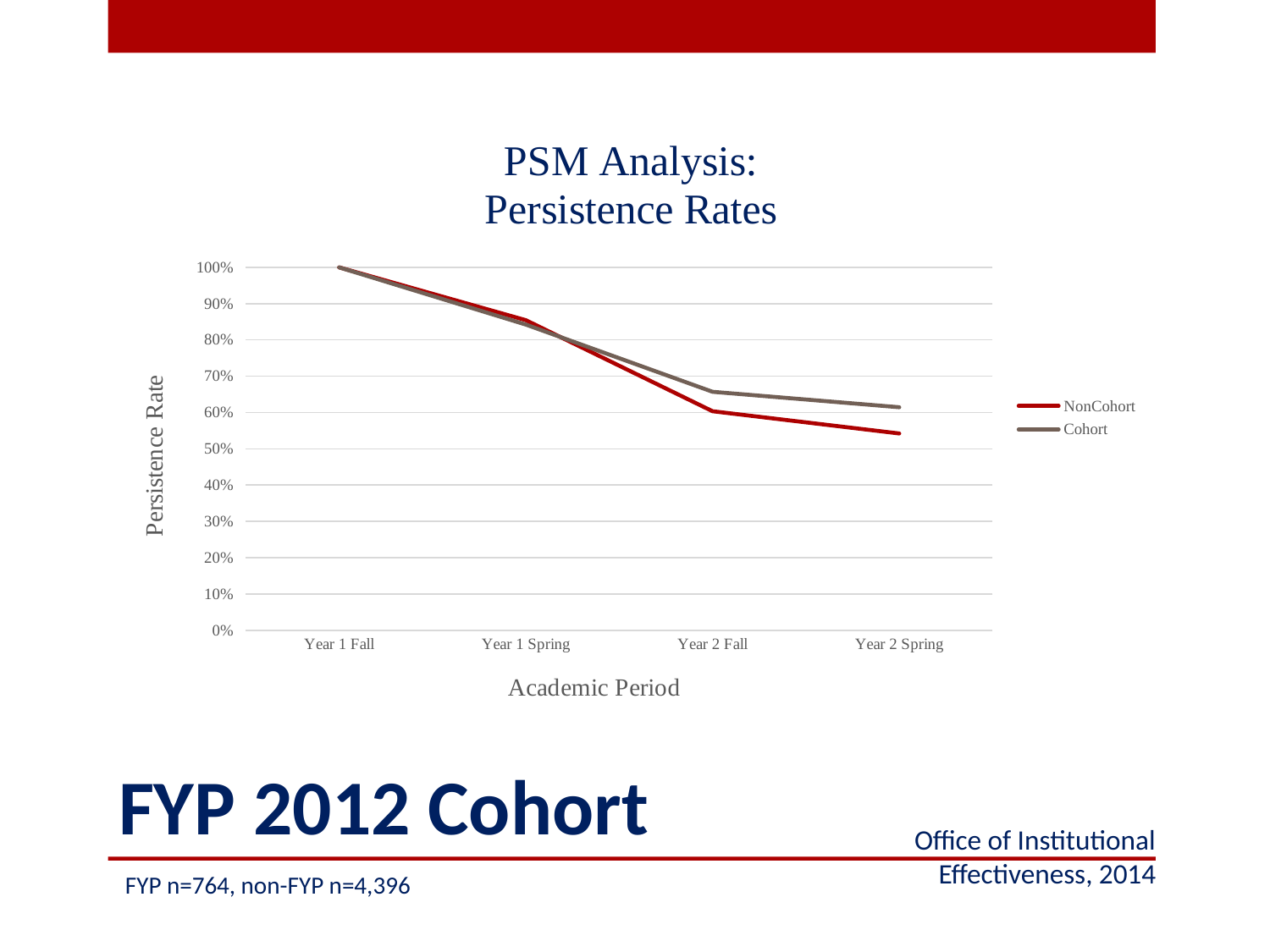
What is the persistence rate for Cohort at Year 1 Fall? 100% Is the NonCohort value at Year 2 Spring greater or less than 60%? less Do the persistence rates rise or fall from Year 1 Fall to Year 2 Spring? fall What is the persistence rate for NonCohort at Year 1 Fall? 100% What kind of chart is shown on the slide? line chart At Year 2 Spring, which series has the higher persistence rate, Cohort or NonCohort? Cohort Is the NonCohort value at Year 1 Spring greater or less than 80%? greater Is the Cohort value at Year 2 Fall greater or less than 70%? less How many academic periods are plotted along the x axis? 4 What is the title of the chart? PSM Analysis: Persistence Rates How many series does the legend list? 2 At Year 2 Fall, which series has the higher persistence rate, Cohort or NonCohort? Cohort